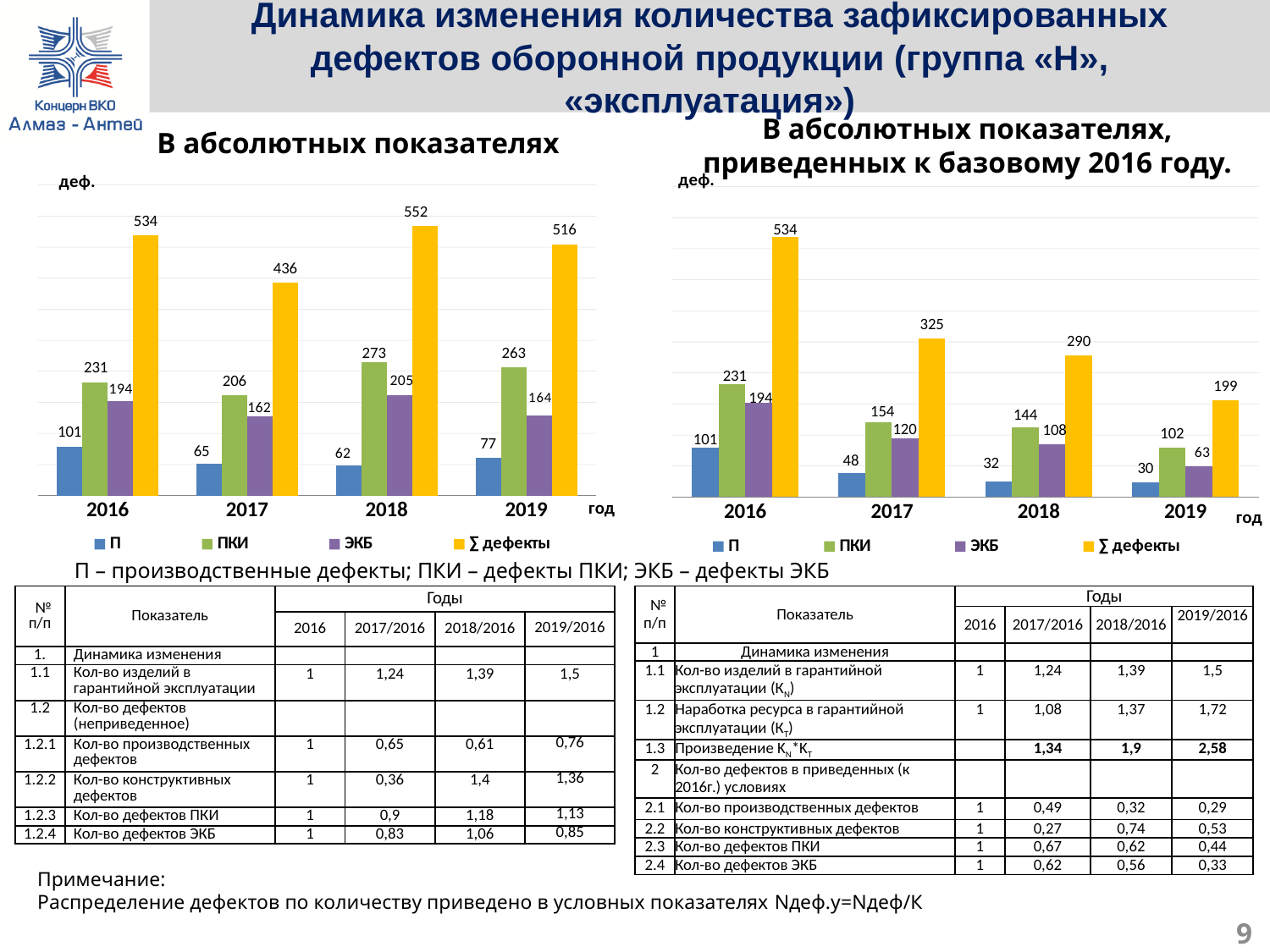
In the right chart 'приведенных к базовому 2016 году', what is the value of Σ дефекты for 2017? 325 In the left chart 'В абсолютных показателях', what is the difference between the ПКИ values for 2018 and 2017? 67 In the right chart 'приведенных к базовому 2016 году', what is the value of ЭКБ for 2019? 63 In the left chart 'В абсолютных показателях', which year has the highest Σ дефекты value? 2018 In the right chart 'приведенных к базовому 2016 году', do the Σ дефекты values rise or fall from 2016 to 2019? fall In the right chart 'приведенных к базовому 2016 году', which is larger: ПКИ for 2017 or ПКИ for 2018? ПКИ for 2017 In the left chart 'В абсолютных показателях', what is the value of Σ дефекты for 2018? 552 In the right chart 'приведенных к базовому 2016 году', what is the difference between Σ дефекты for 2016 and 2019? 335 What type of chart is the right chart 'приведенных к базовому 2016 году'? bar chart How many series does the legend of the left chart 'В абсолютных показателях' list? 4 In the left chart 'В абсолютных показателях', which year has the lowest П value? 2018 In the left chart 'В абсолютных показателях', what is the value of П for 2017? 65